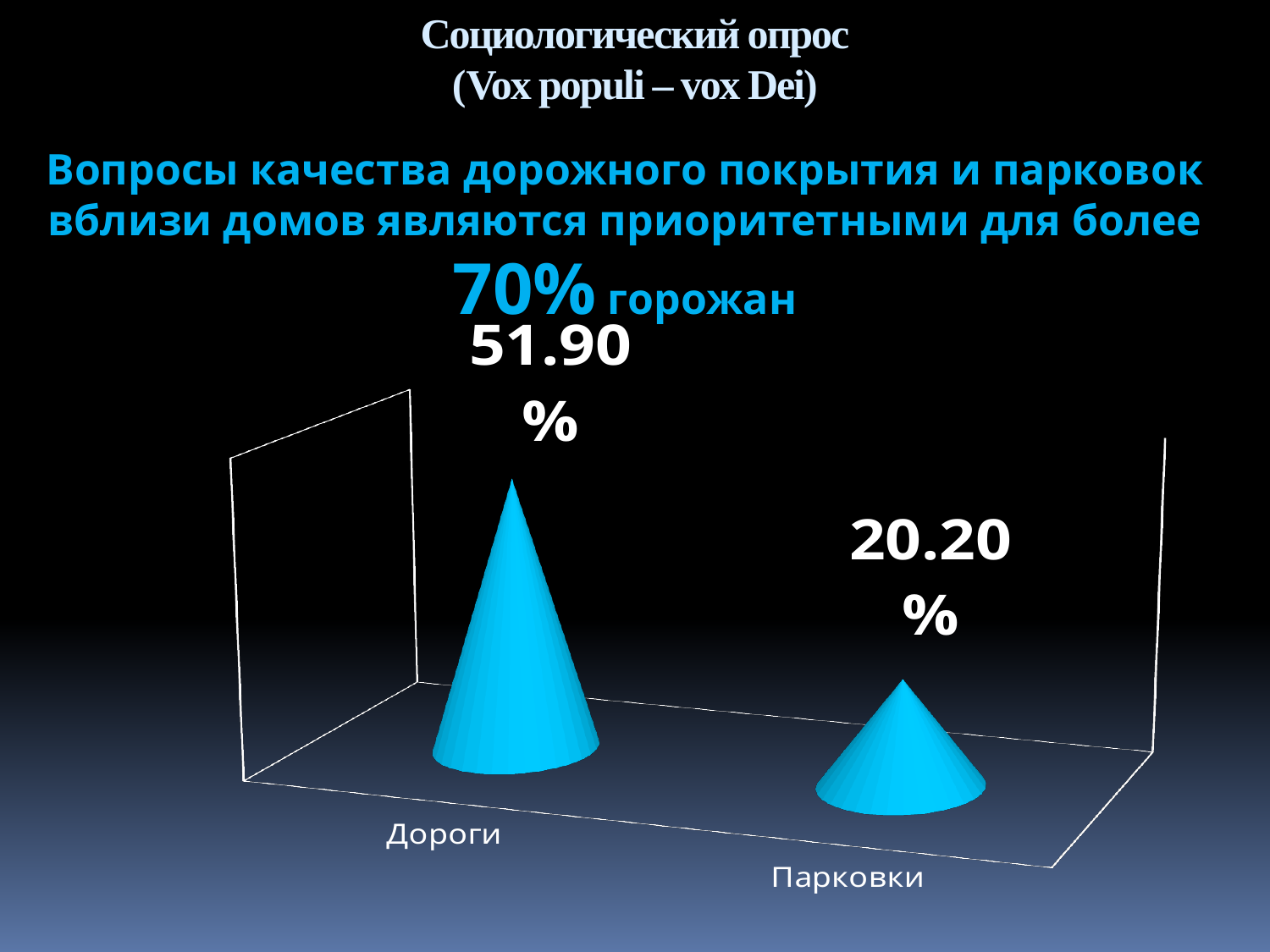
Do the values rise or fall from Дороги to Парковки? Fall What kind of chart is shown on the slide? Bar chart Which category has the highest value? Дороги Which category has the lowest value? Парковки What is the difference between the values for Дороги and Парковки? 31.70% Which is larger, the value for Дороги or the value for Парковки? Дороги What is the value for Дороги? 51.90% What is the title at the top of the slide? Социологический опрос (Vox populi – vox Dei) How many categories are shown in the chart? 2 What colour are the bars in the chart? Blue What is the value for Парковки? 20.20%